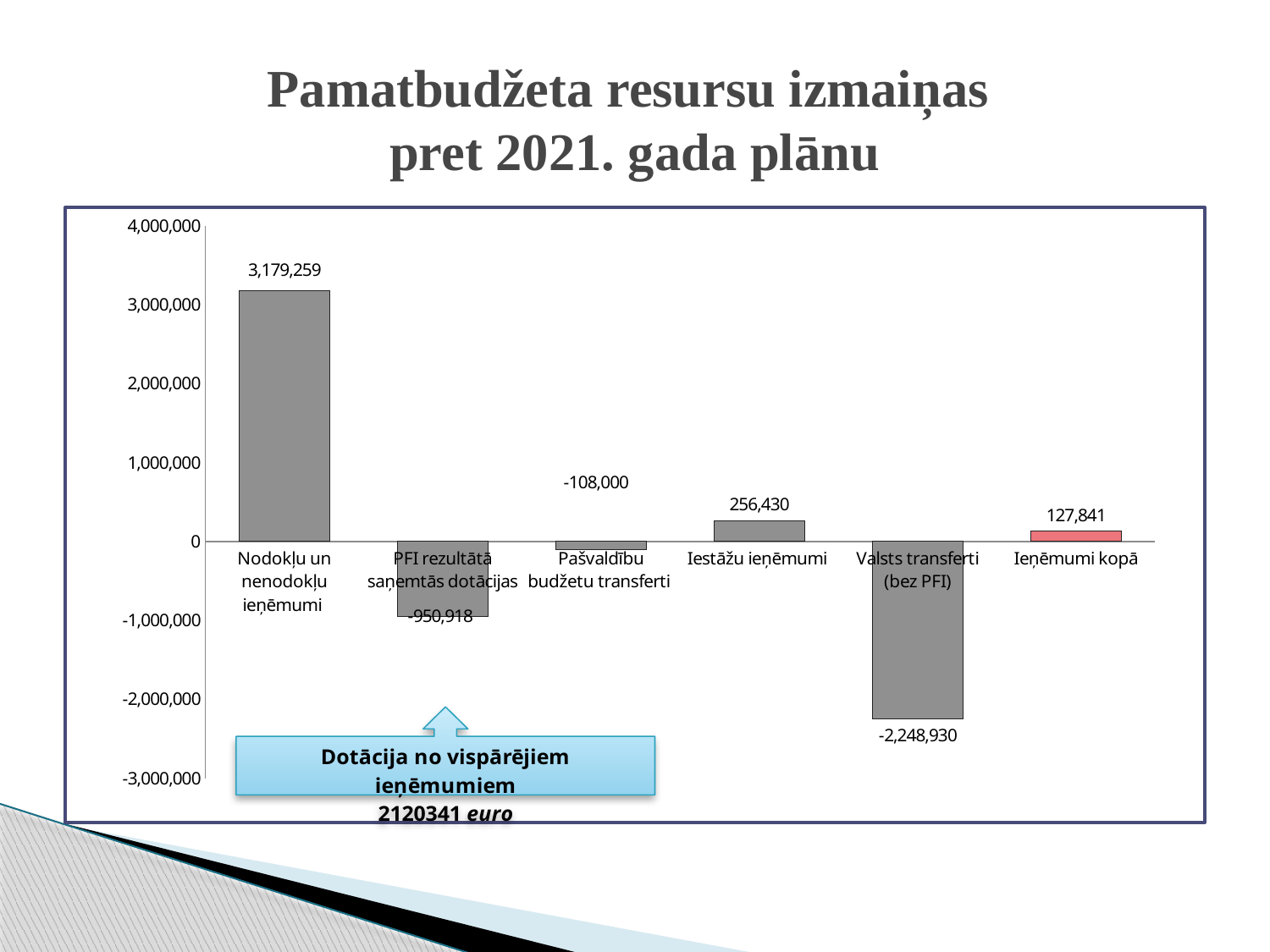
Is the value for PFI rezultātā saņemtās dotācijas greater or less than -1,000,000? greater Which category has the lowest value? Valsts transferti (bez PFI) Which category has the highest value? Nodokļu un nenodokļu ieņēmumi What is the value for Nodokļu un nenodokļu ieņēmumi? 3,179,259 What is the value for Valsts transferti (bez PFI)? -2,248,930 Which bar is coloured differently (red) from the others? Ieņēmumi kopā What is the value for Pašvaldību budžetu transferti? -108,000 What is the difference between the values for Iestāžu ieņēmumi and Ieņēmumi kopā? 128,589 Which is larger, the value for Iestāžu ieņēmumi or the value for Ieņēmumi kopā? Iestāžu ieņēmumi What kind of chart is shown on the slide? bar chart What is the value for Ieņēmumi kopā? 127,841 How many categories are shown on the chart? 6